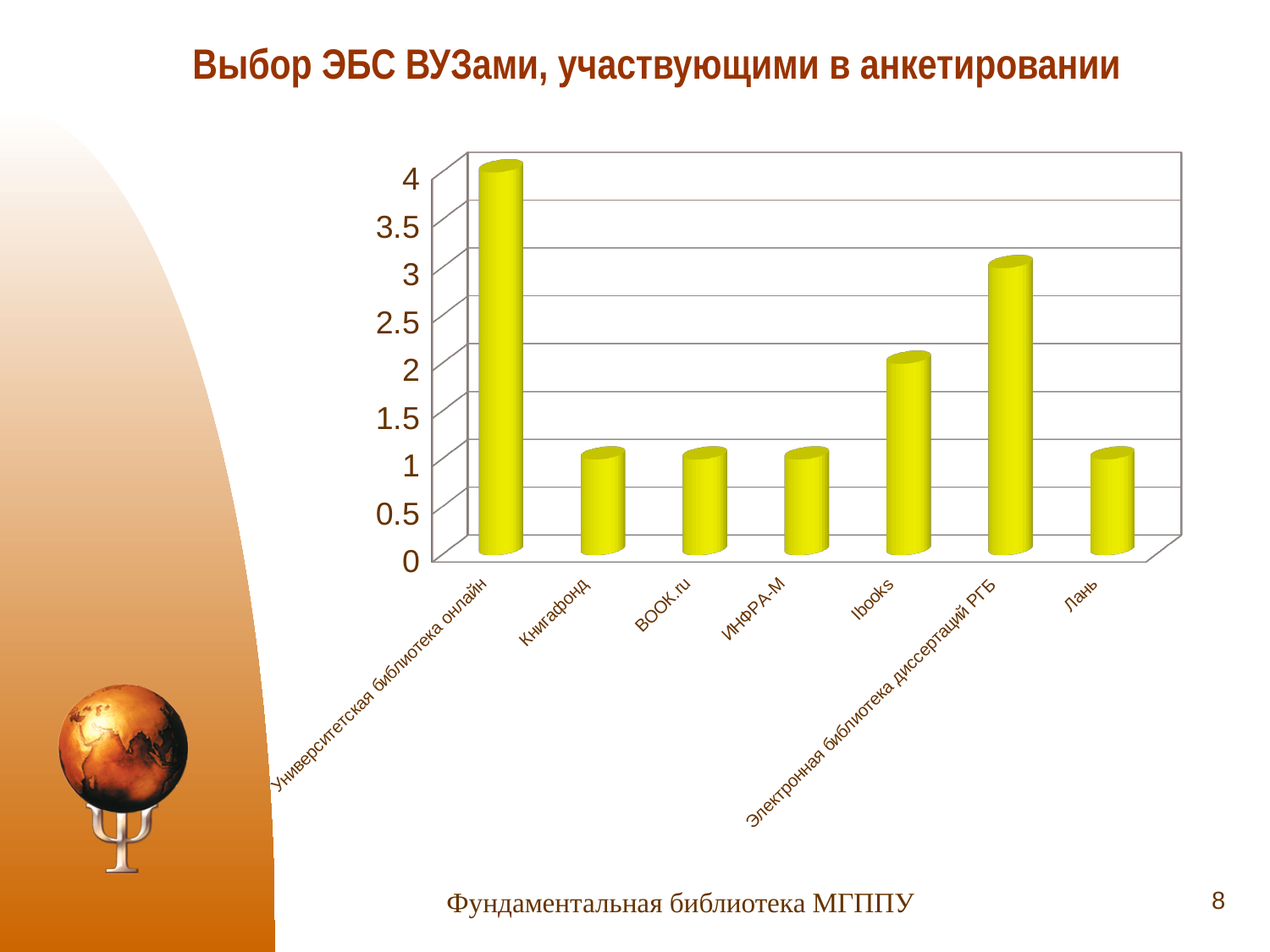
Which is larger, the value for Ibooks or the value for Электронная библиотека диссертаций РГБ? Электронная библиотека диссертаций РГБ What is the difference between the values for Университетская библиотека онлайн and Электронная библиотека диссертаций РГБ? 1 What is the value for Ibooks? 2 How many categories (ЭБС) are shown on the x axis? 7 What is the value for Электронная библиотека диссертаций РГБ? 3 What is the title of the slide containing the chart? Выбор ЭБС ВУЗами, участвующими в анкетировании What is the value for Лань? 1 What is the value for Университетская библиотека онлайн? 4 Is the value for Ibooks greater or less than 1.5? greater What kind of chart is shown on the slide? bar chart Which category has the highest bar? Университетская библиотека онлайн What is the difference between the values for Университетская библиотека онлайн and Ibooks? 2